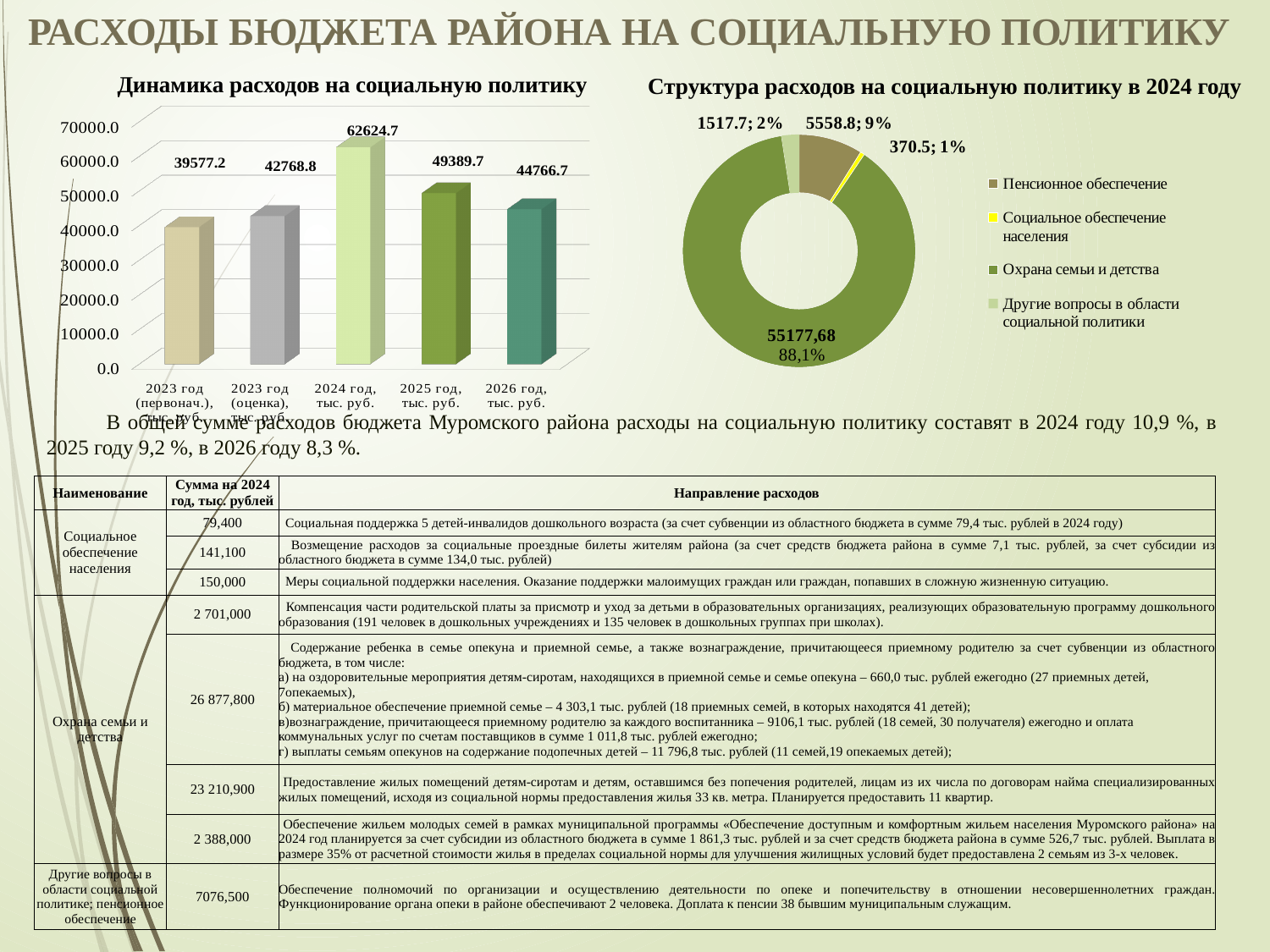
On the chart 'Динамика расходов на социальную политику', what is the difference between the values for 2025 год and 2026 год? 4623.0 On the chart 'Динамика расходов на социальную политику', which category has the highest value? 2024 год On the chart 'Динамика расходов на социальную политику', how many bars are plotted? 5 What kind of chart is 'Динамика расходов на социальную политику'? Bar chart On the chart 'Динамика расходов на социальную политику', do the values rise or fall from 2024 год to 2026 год? Fall How many entries does the legend of the chart 'Структура расходов на социальную политику в 2024 году' list? 4 On the chart 'Структура расходов на социальную политику в 2024 году', what share does 'Охрана семьи и детства' have? 88,1% On the chart 'Структура расходов на социальную политику в 2024 году', what is the value for 'Пенсионное обеспечение'? 5558.8 On the chart 'Динамика расходов на социальную политику', what is the value for 2023 год (оценка)? 42768.8 On the chart 'Динамика расходов на социальную политику', which is larger: the value for 2025 год or the value for 2023 год (оценка)? 2025 год On the chart 'Динамика расходов на социальную политику', what is the value for 2024 год? 62624.7 On the chart 'Динамика расходов на социальную политику', which category has the lowest value? 2023 год (первонач.)